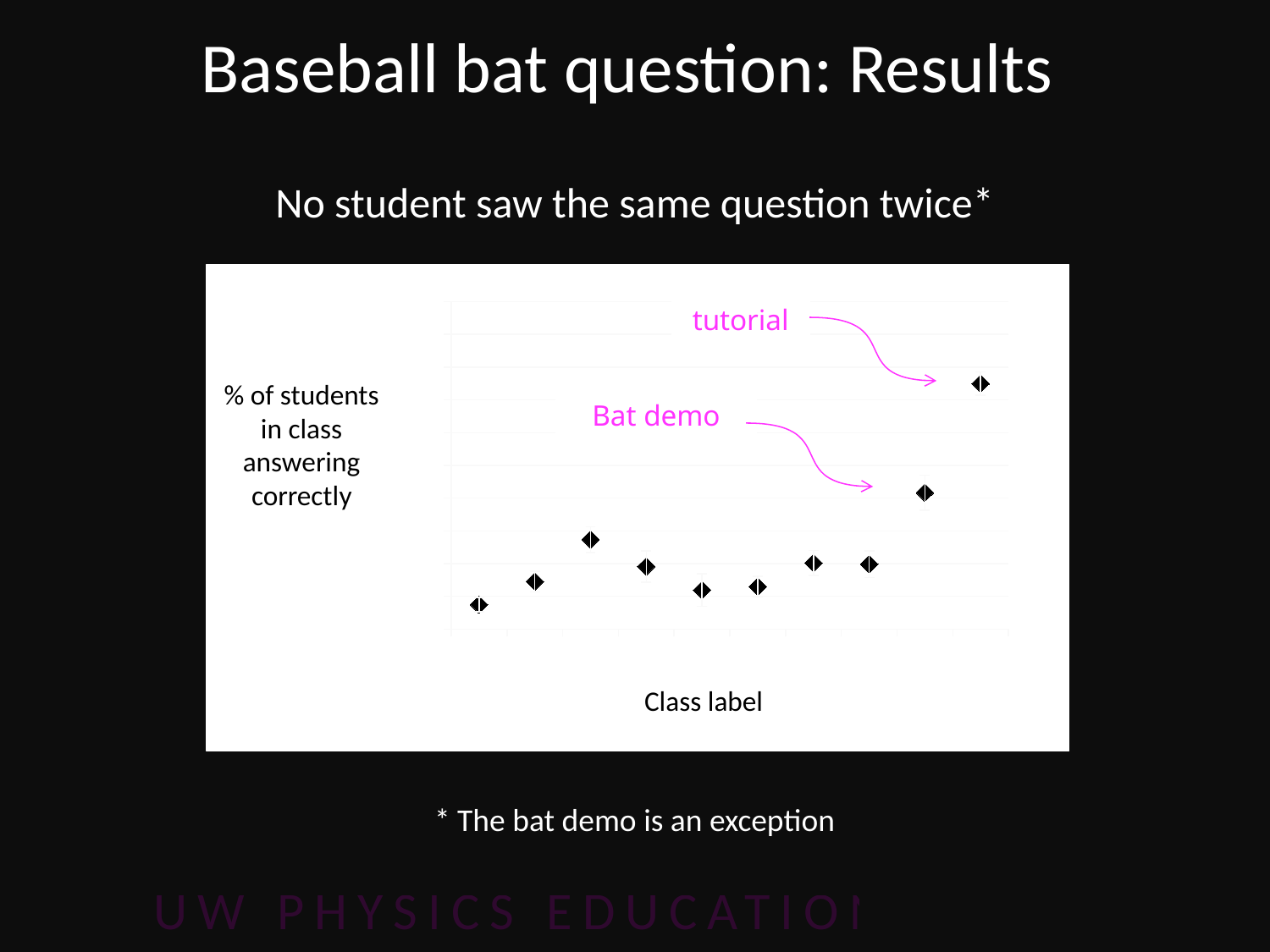
Is the leftmost point the lowest value in the chart? yes Which annotated point has the highest value in the chart? tutorial Which annotated point has the second-highest value in the chart? Bat demo What is the label of the vertical axis of the chart? % of students in class answering correctly What is the label of the horizontal axis of the chart? Class label What kind of chart is shown on the slide? scatter chart Do the plotted values generally rise or fall from left to right along the x axis? rise How many data points are plotted in the chart? 10 Is the rightmost point the highest value in the chart? yes Which has the higher value, the point labelled "tutorial" or the point labelled "Bat demo"? tutorial